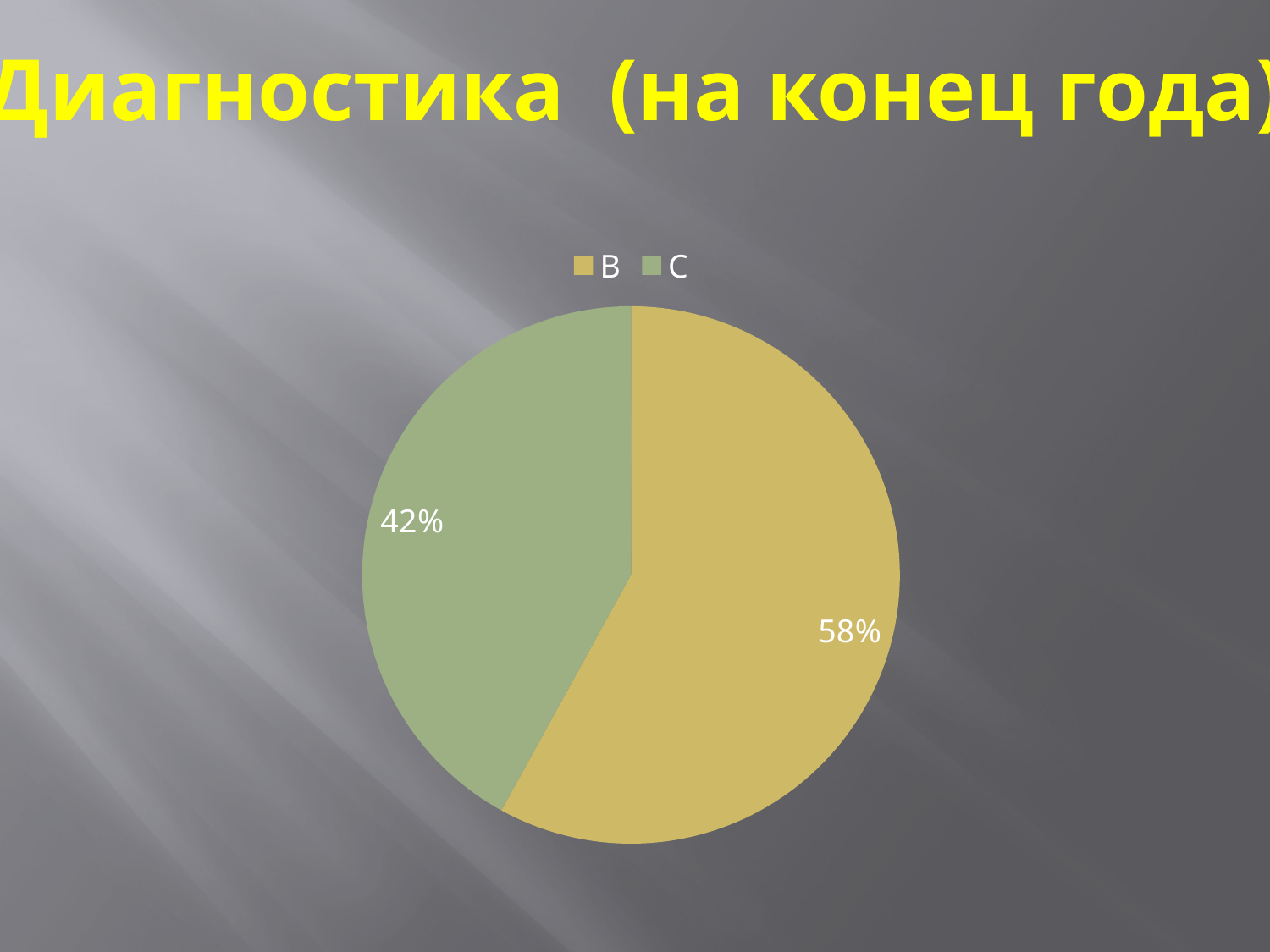
Which is larger, B or C? B Which slice is the smallest? C What is the value shown for slice C? 42% Which slice is the largest? B What share of the pie does slice B take? 58% What is the value shown for slice B? 58% How many slices does the pie chart have? 2 What is the title of the slide? Диагностика (на конец года) What is the difference between the values for B and C? 16% What kind of chart is shown on the slide? pie chart How many entries does the legend list? 2 What colour is slice C? green